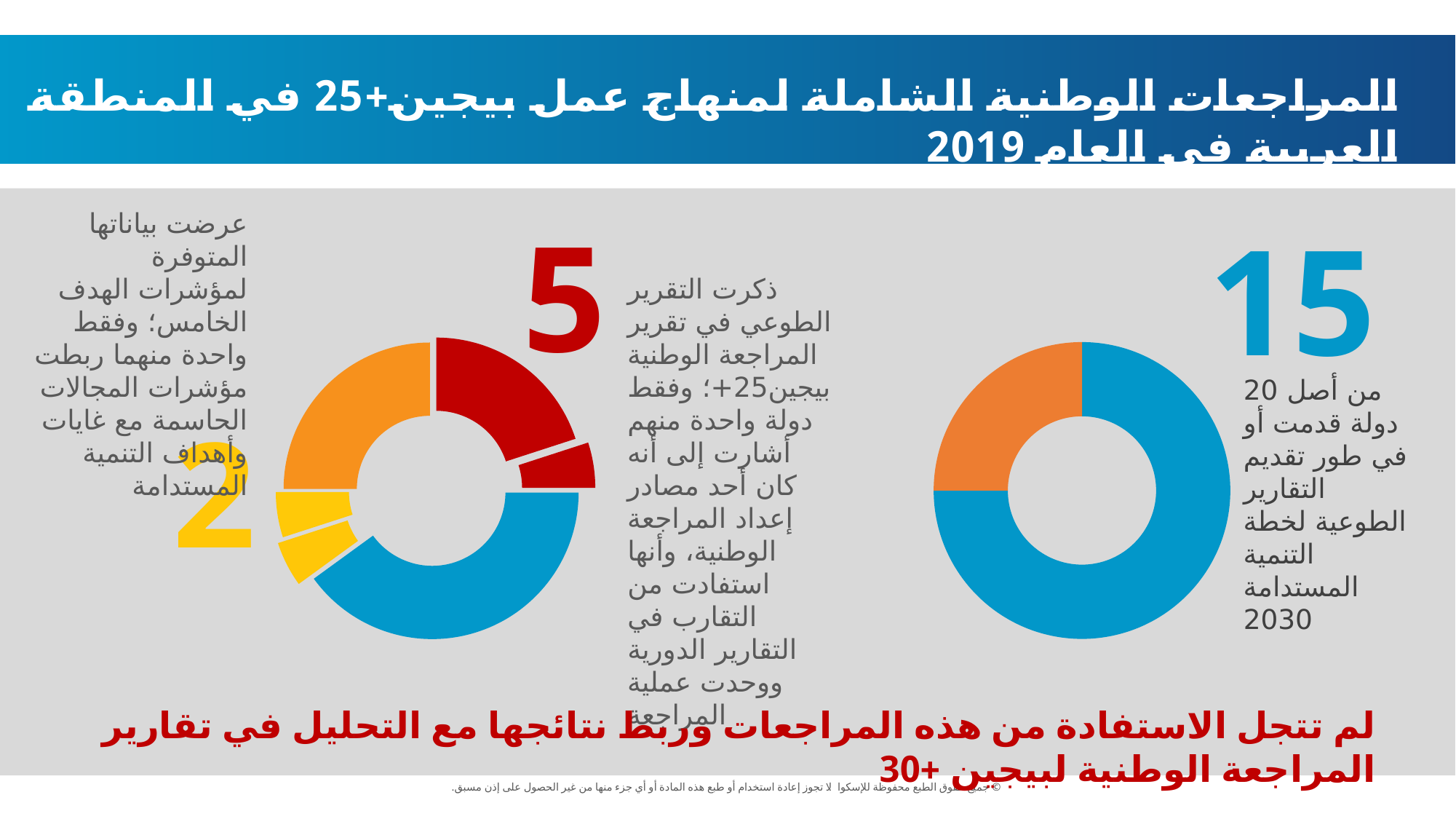
What kind of chart is shown on the right side of the slide? Donut (pie) chart In the left chart, which is larger: the red value or the yellow value? Red (5) In the left chart, what is the difference between the red value and the yellow value? 3 In the right chart, how many segments does the donut have? 2 What large number is printed next to the right chart? 15 What kind of chart is shown on the left side of the slide? Donut (pie) chart In the left chart, what number is printed in red next to the red segment? 5 In the right chart, which colour segment is the largest? Blue In the left chart, what number is printed in yellow next to the yellow segment? 2 In the right chart, which colour segment is the smallest? Orange According to the text next to the right chart, out of how many countries is the 15 counted? 20 In the right chart, what share of the 20 countries does the 15 represent? 75%